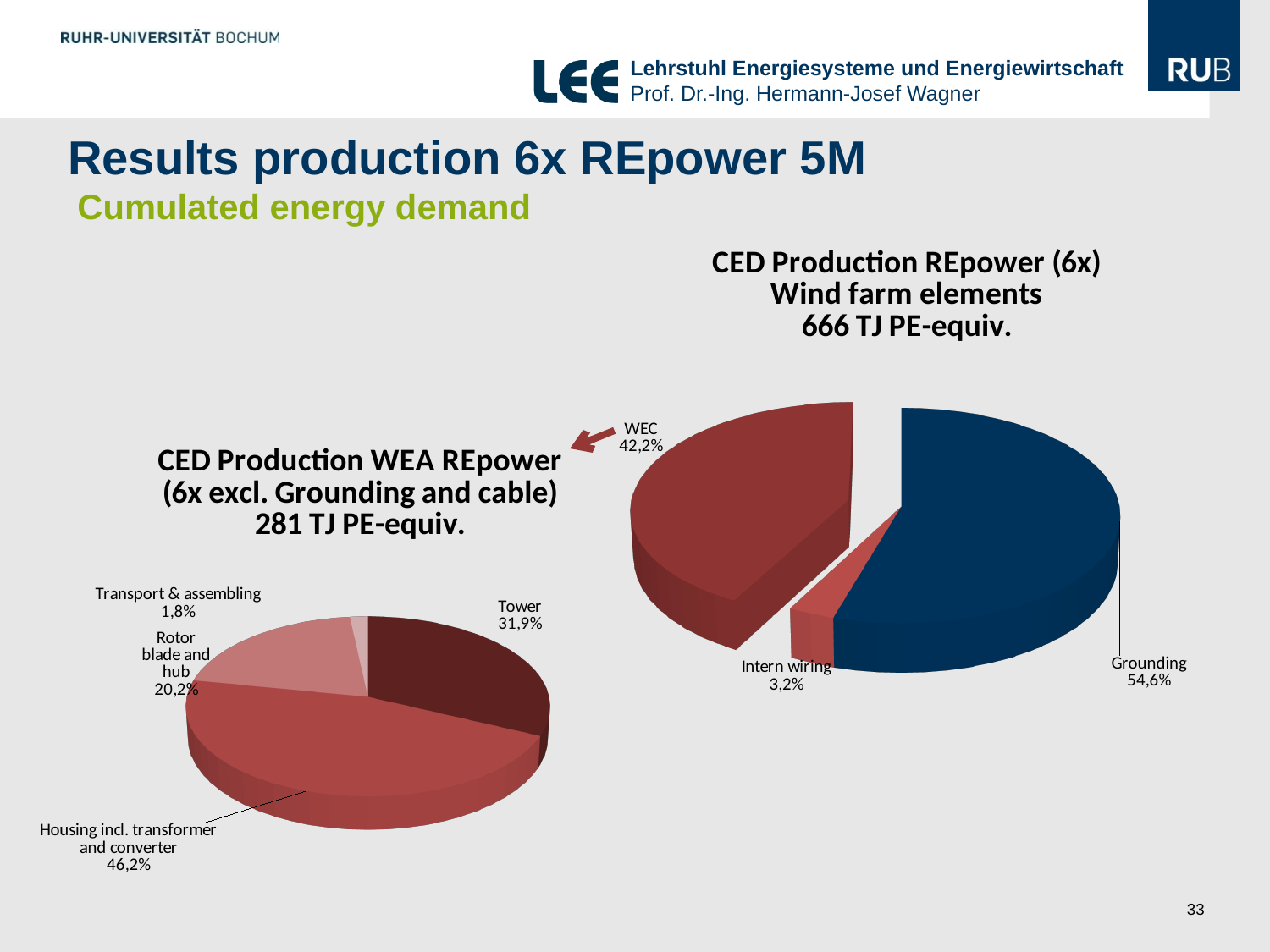
In the 'CED Production WEA REpower (6x excl. Grounding and cable)' chart, how many slices does the pie have? 4 In the 'CED Production WEA REpower (6x excl. Grounding and cable)' chart, what share does Tower have? 31,9% In the 'CED Production REpower (6x) Wind farm elements' chart, how many slices does the pie have? 3 In the 'CED Production REpower (6x) Wind farm elements' chart, what share does Grounding have? 54,6% In the 'CED Production WEA REpower (6x excl. Grounding and cable)' chart, which component has the largest share? Housing incl. transformer and converter In the 'CED Production WEA REpower (6x excl. Grounding and cable)' chart, which component has the smallest share? Transport & assembling In the 'CED Production REpower (6x) Wind farm elements' chart, which element has the smallest share? Intern wiring What total value in TJ PE-equiv. is stated in the title of the 'CED Production REpower (6x) Wind farm elements' chart? 666 TJ PE-equiv. In the 'CED Production REpower (6x) Wind farm elements' chart, what is the difference in percentage points between Grounding and WEC? 12,4 In the 'CED Production WEA REpower (6x excl. Grounding and cable)' chart, which is larger: Rotor blade and hub or Tower? Tower What kind of chart is used for 'CED Production WEA REpower (6x excl. Grounding and cable)'? Pie chart In the 'CED Production REpower (6x) Wind farm elements' chart, what share does WEC have? 42,2%